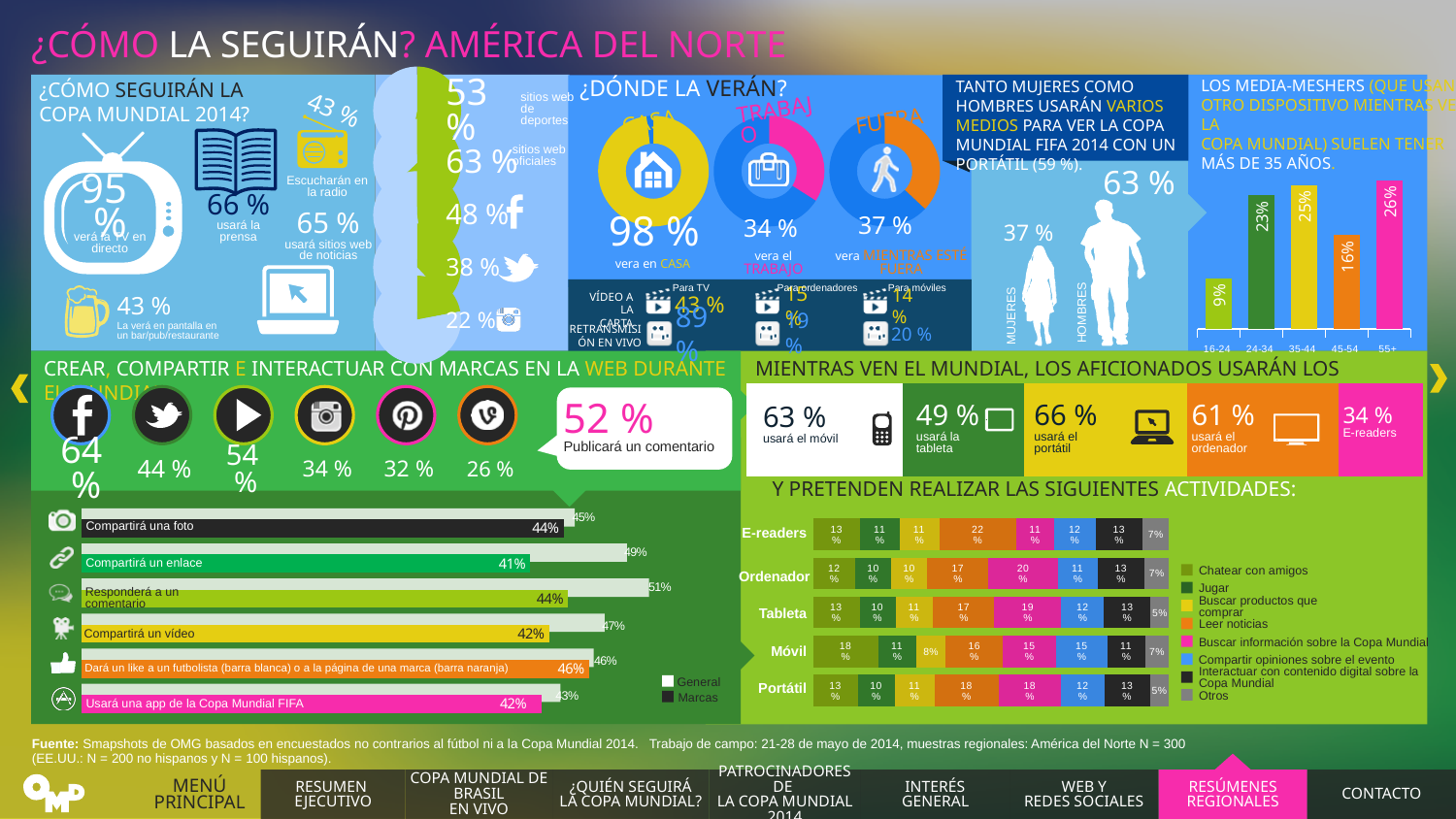
In the horizontal bar chart at the bottom left (General vs Marcas), what is the Marcas value for 'Responderá a un comentario'? 44% What type of chart is used for 'Y pretenden realizar las siguientes actividades'? Stacked bar chart In the bar chart of media-meshers by age group (top right), how many age groups are shown? 5 In the stacked bar chart 'Y pretenden realizar las siguientes actividades', what is the 'Chatear con amigos' value for Móvil? 18% In the horizontal bar chart at the bottom left, how many series does the legend list? 2 In the bar chart of media-meshers by age group (top right), which age group has the lowest value? 16-24 In the stacked bar chart 'Y pretenden realizar las siguientes actividades', how many device categories are shown? 5 In the stacked bar chart 'Y pretenden realizar las siguientes actividades', what is the 'Leer noticias' value for E-readers? 22% In the horizontal bar chart at the bottom left (General vs Marcas), what is the General value for 'Compartirá un enlace'? 49% In the bar chart of media-meshers by age group (top right), what is the value for the 16-24 age group? 9% In the horizontal bar chart at the bottom left, which is larger for 'Compartirá un vídeo': the General value or the Marcas value? General In the bar chart of media-meshers by age group (top right), what is the difference between the 24-34 and 45-54 values? 7%